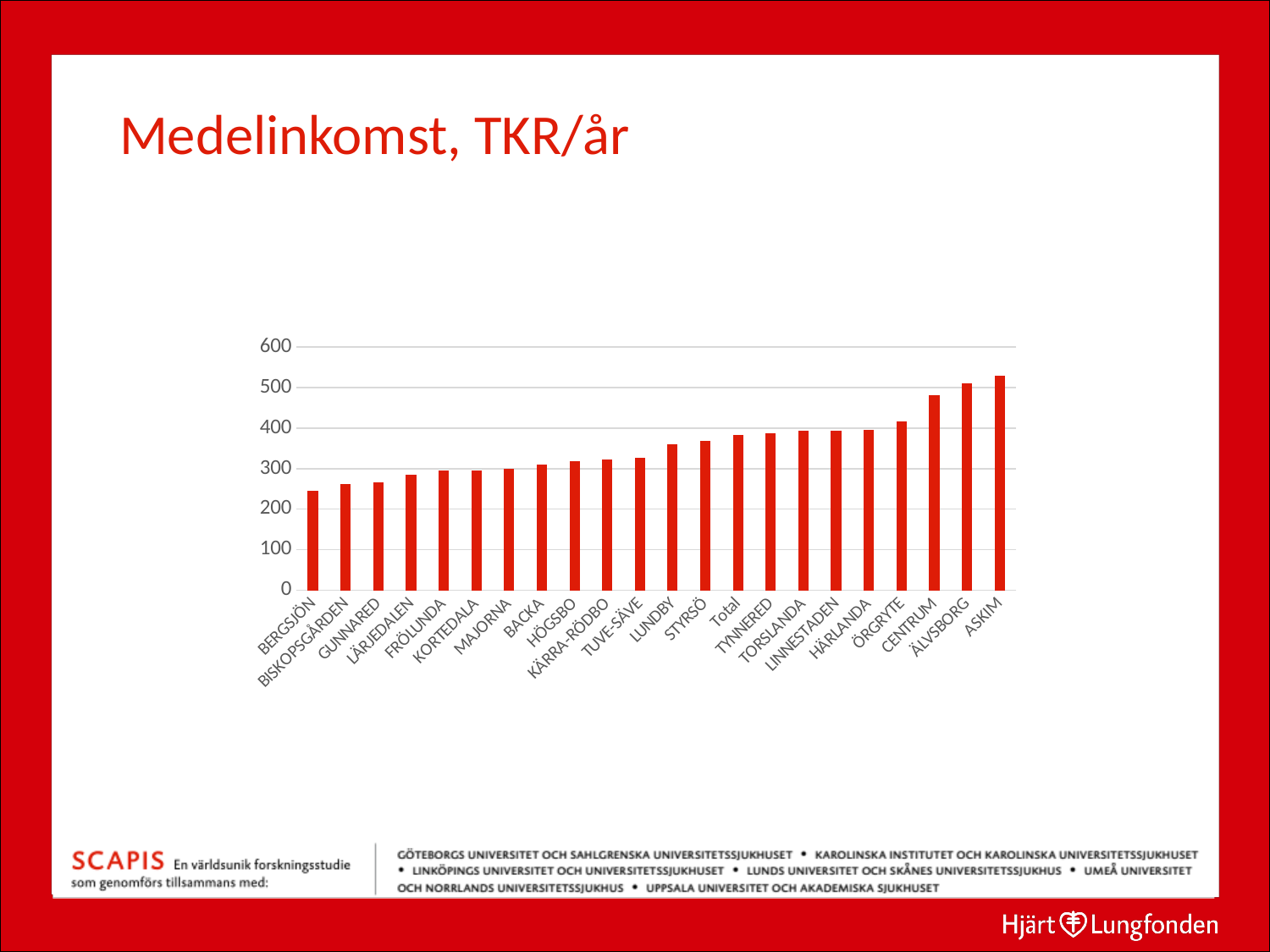
Do the values rise or fall from left to right along the x axis? Rise Is the value for ASKIM greater or less than 500? greater Which is larger, the value for CENTRUM or the value for LUNDBY? CENTRUM Is the value for CENTRUM greater or less than 400? greater Which category has the lowest value in the chart? BERGSJÖN Is the value for LUNDBY greater or less than 400? less What is the highest value shown on the y axis? 600 What is the title of the chart on the slide? Medelinkomst, TKR/år What kind of chart is shown on the slide? Bar chart How many bars are plotted in the chart? 22 Which category has the highest value in the chart? ASKIM